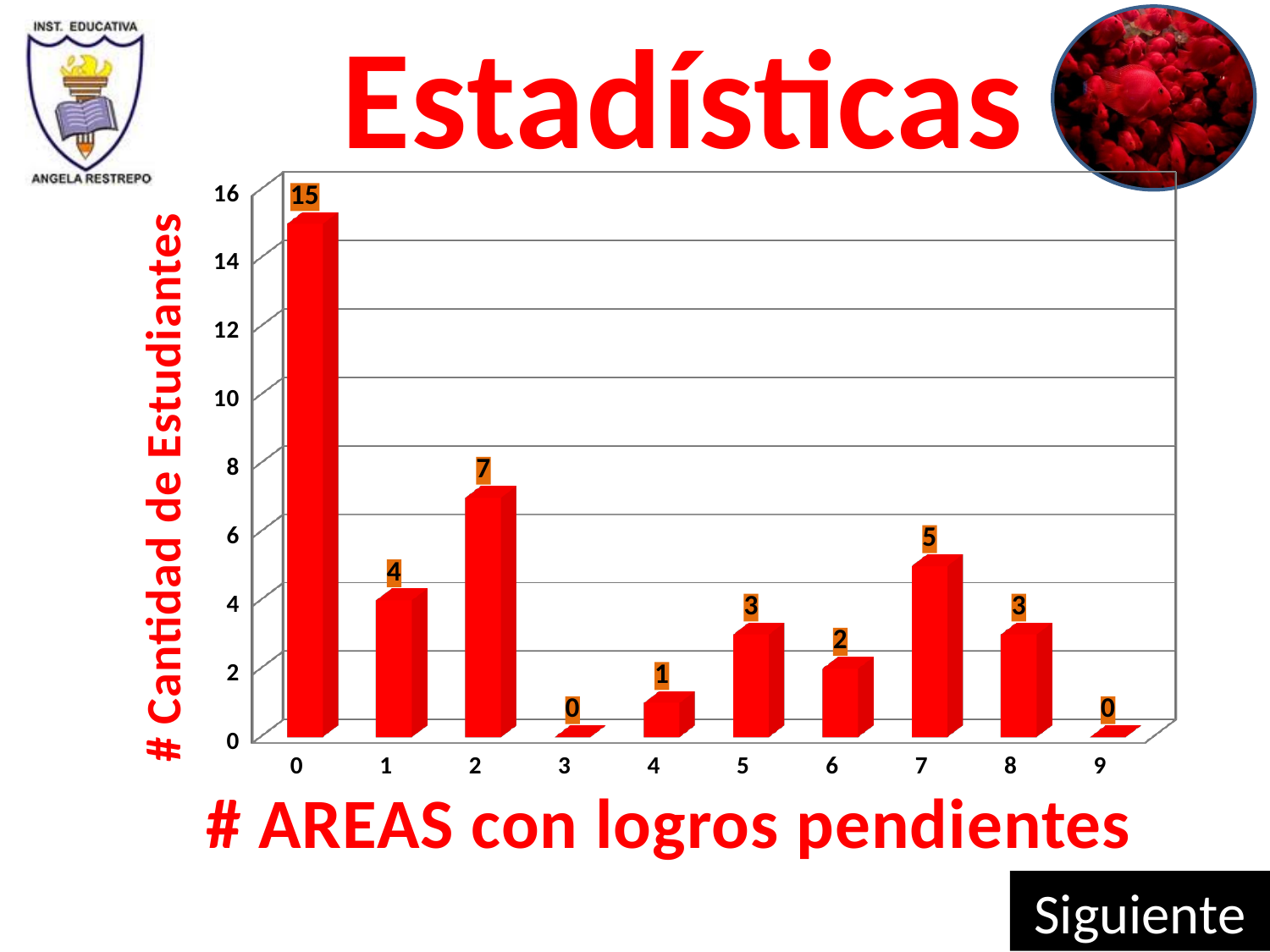
How many students have 0 areas with pending achievements? 15 Which categories have a value of 0 students? 3 and 9 Which category on the x axis has the highest number of students? 0 What type of chart is shown on the slide? Bar chart What is the label of the x axis? # AREAS con logros pendientes What is the label of the y axis? # Cantidad de Estudiantes What is the total number of students for categories 5 and 8 combined? 6 Which has more students: category 1 or category 7? 7 How many categories are shown on the x axis? 10 What is the value shown for category 7 on the x axis? 5 What is the difference between the number of students for category 0 and category 2? 8 What is the number of students for 2 areas with pending achievements? 7